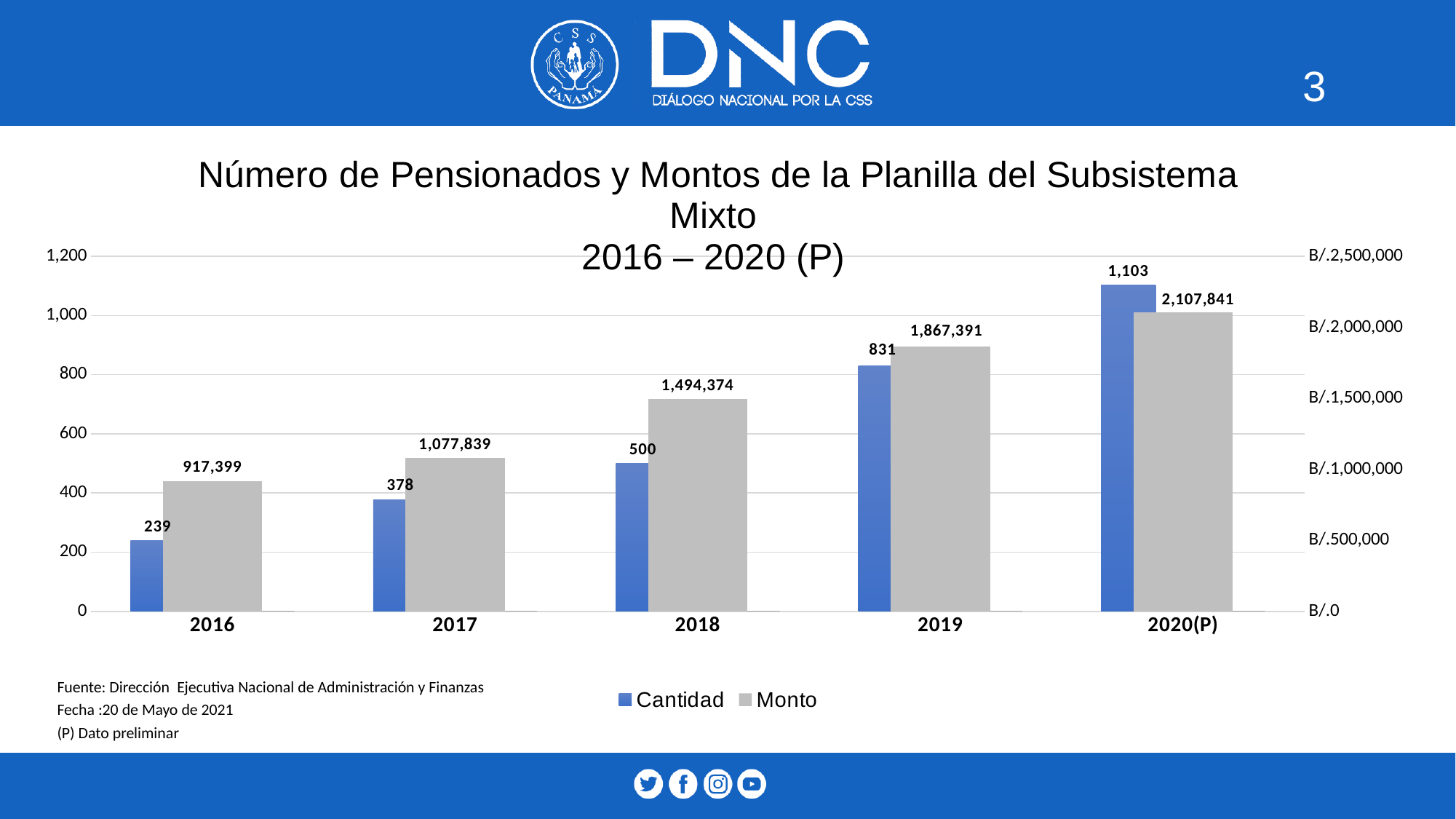
What is the Cantidad value for 2018? 500 What is the Monto value for 2019? 1,867,391 What is the Cantidad value for 2020(P)? 1,103 Which year has the highest Monto value? 2020(P) Which year has the lowest Cantidad value? 2016 Do the Cantidad values rise or fall from 2016 to 2020(P)? Rise What kind of chart is shown on the slide? Bar chart How many years are shown on the x axis? 5 What is the difference between the Monto values for 2020(P) and 2019? 240,450 What is the difference between the Cantidad values for 2017 and 2016? 139 How many series does the legend list? 2 Which is larger, the Cantidad value for 2018 or for 2019? 2019